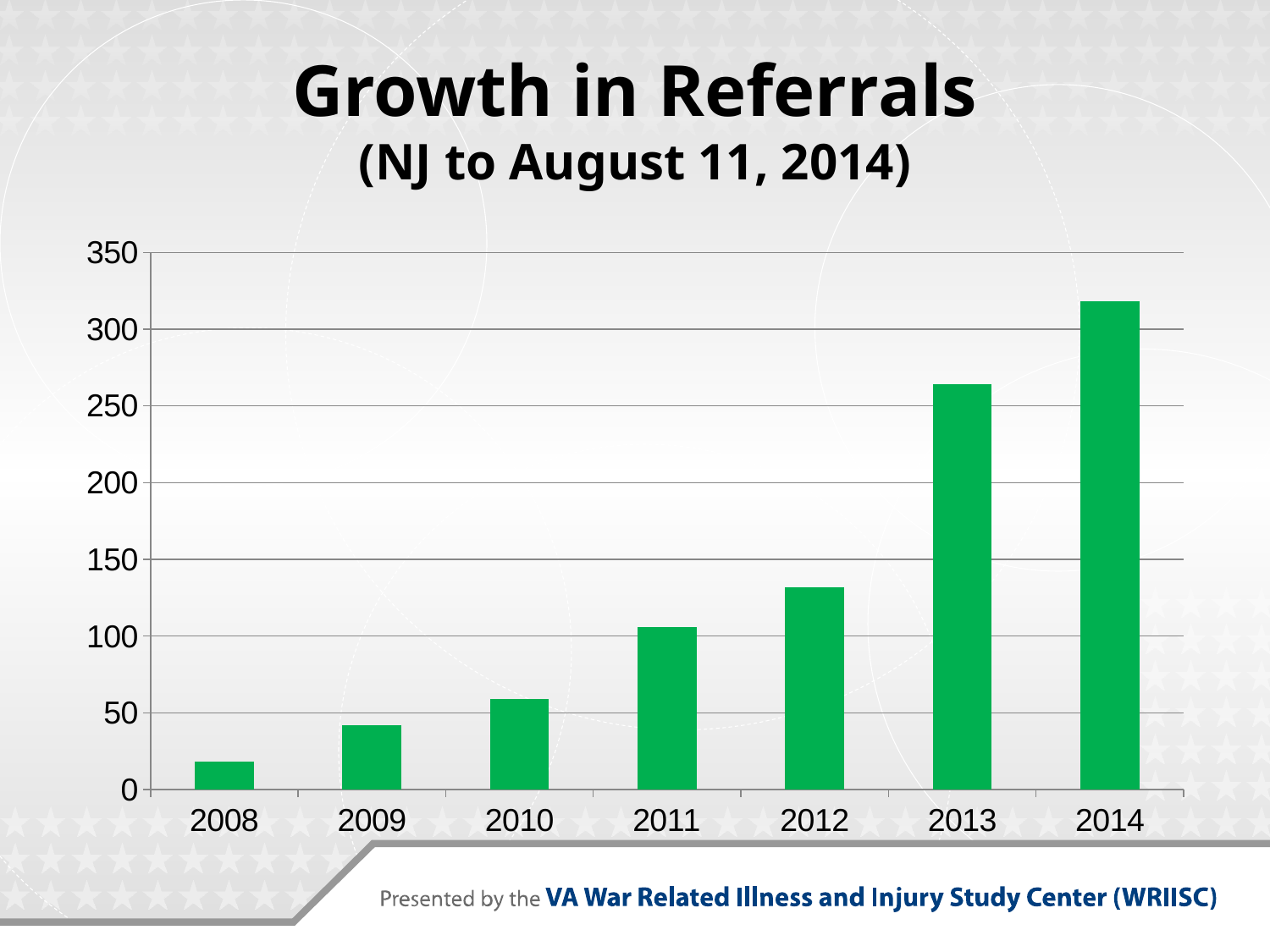
Is the value for 2011 greater or less than 100? greater Which year has the highest number of referrals? 2014 Is the value for 2012 greater or less than 150? less Is the value for 2014 greater or less than 300? greater What is the title of the chart? Growth in Referrals (NJ to August 11, 2014) What kind of chart is shown on the slide? bar chart Which is larger, the value for 2013 or the value for 2012? 2013 Which year has the lowest number of referrals? 2008 Do the referral values rise or fall from 2008 to 2014? rise How many years are plotted on the x axis? 7